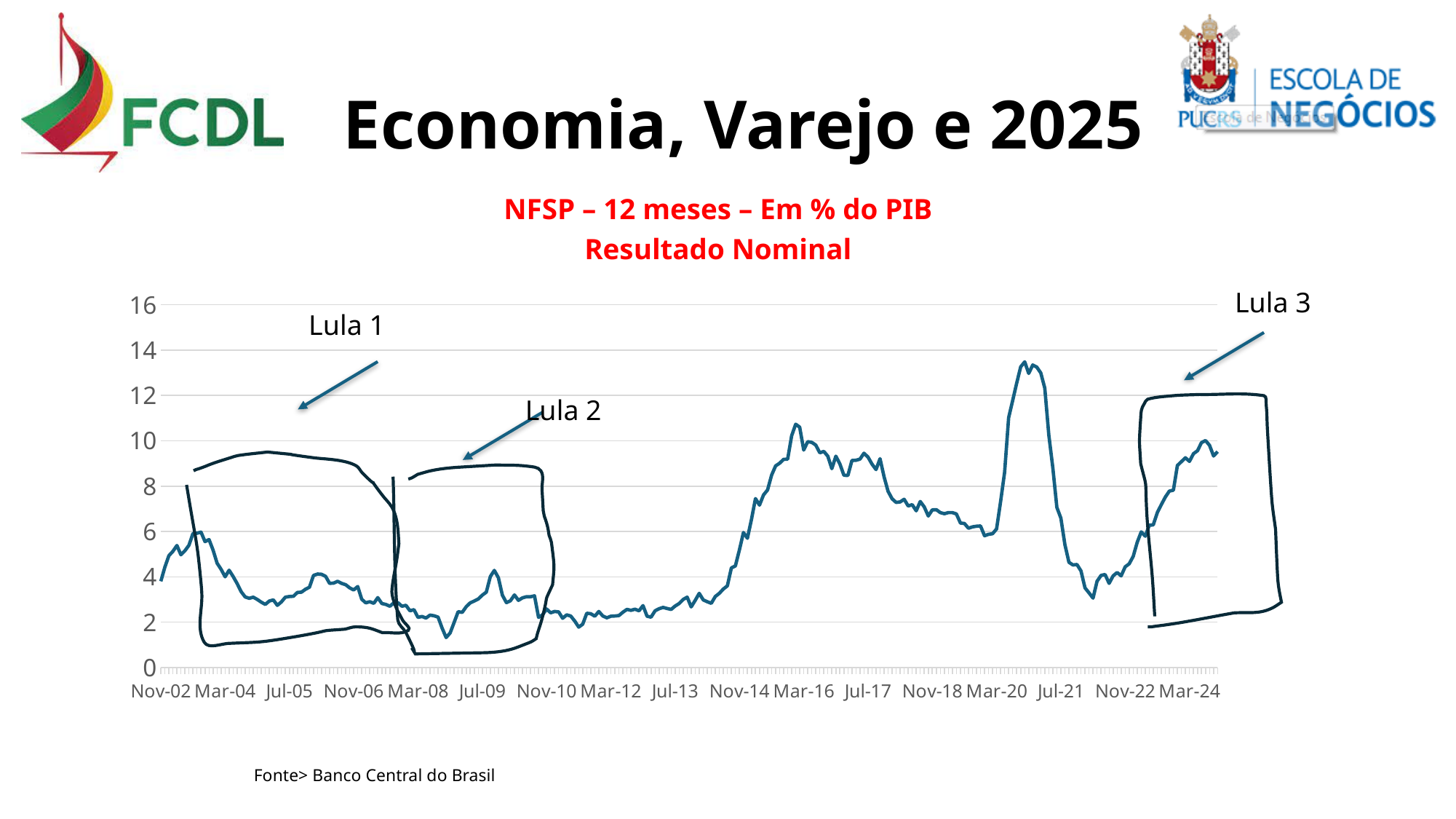
Is the lowest value reached by the line greater or less than 2? less Is the value at Mar-16 greater or less than 8? greater Is the value at Nov-02 greater or less than 6? less Does the line rise or fall between Nov-22 and Mar-24? rise Does the line rise or fall between Nov-14 and Mar-16? rise What is the title of the chart? NFSP – 12 meses – Em % do PIB Resultado Nominal How many date labels are shown on the x axis? 17 Which three periods are annotated with arrows on the chart? Lula 1, Lula 2, Lula 3 What kind of chart is shown on the slide? line chart